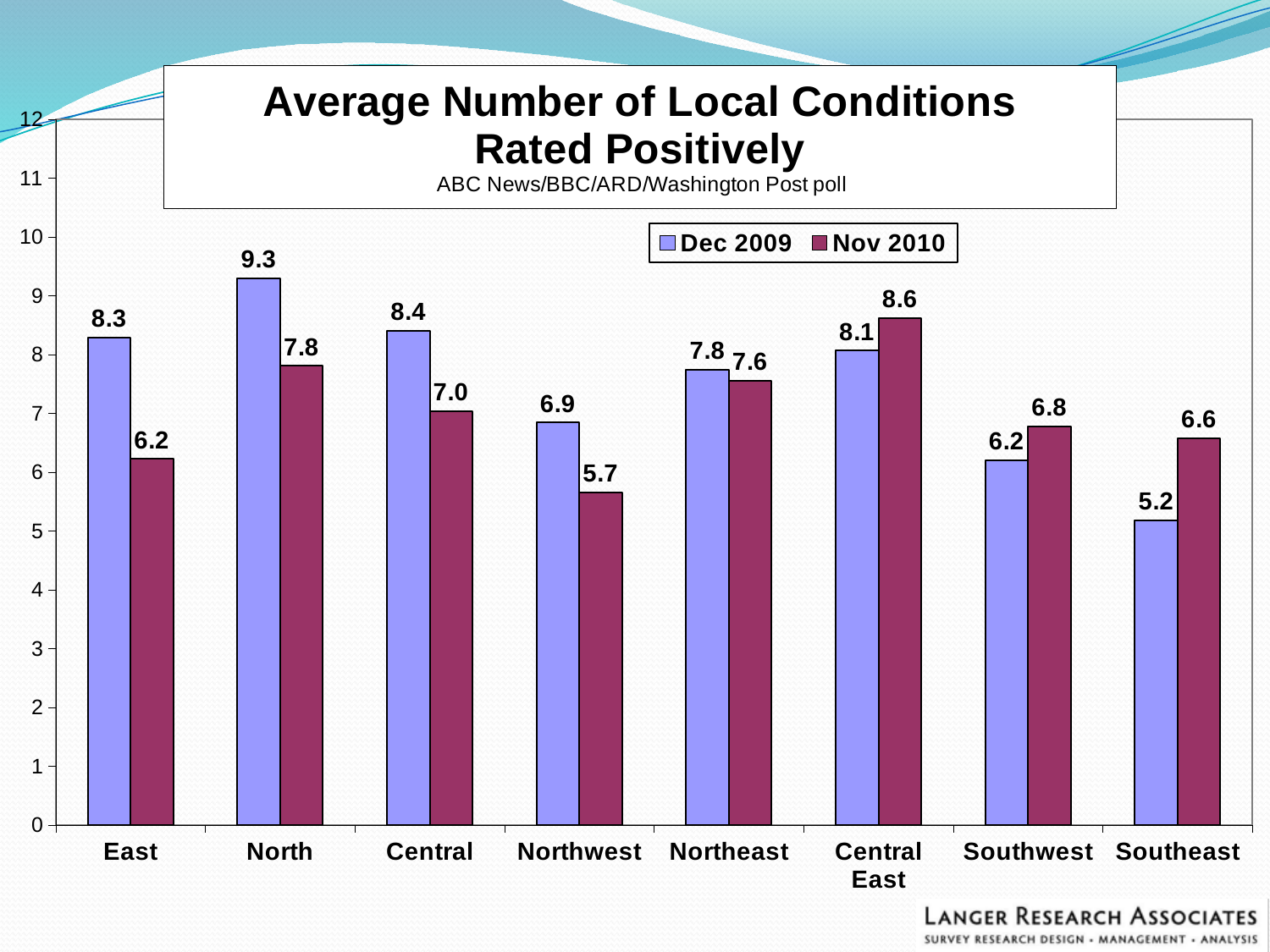
What is the Nov 2010 value for Southeast? 6.6 How many series does the legend list? 2 What is the Nov 2010 value for Northwest? 5.7 Which is larger for Central East: the Dec 2009 value or the Nov 2010 value? Nov 2010 How many regions are shown on the x axis? 8 What kind of chart is shown on the slide? Bar chart Which region has the highest Dec 2009 value? North Which region has the lowest Nov 2010 value? Northwest What is the Dec 2009 value for North? 9.3 Which region has the lowest Dec 2009 value? Southeast Which poll is credited in the chart subtitle? ABC News/BBC/ARD/Washington Post poll What is the difference between the Dec 2009 and Nov 2010 values for East? 2.1